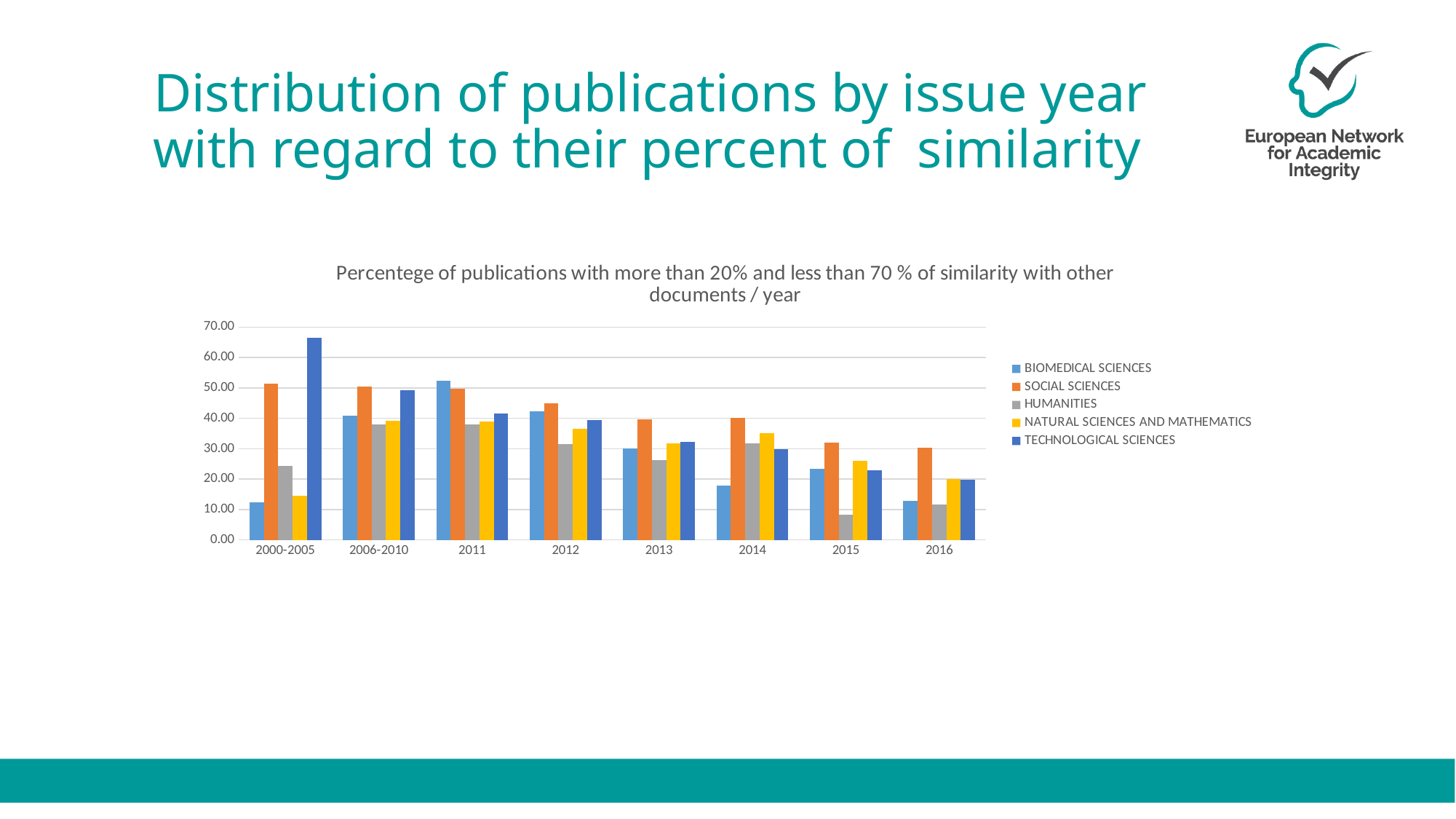
Do the SOCIAL SCIENCES values rise or fall from 2011 to 2016? fall Is the value for TECHNOLOGICAL SCIENCES in 2000-2005 greater or less than 60.00? greater Which series has the tallest bar in the 2000-2005 group? TECHNOLOGICAL SCIENCES Which series has the lowest bar in the 2015 group? HUMANITIES What kind of chart is shown on the slide? bar chart Is the value for HUMANITIES in 2015 greater or less than 10.00? less In 2014, which is larger: SOCIAL SCIENCES or BIOMEDICAL SCIENCES? SOCIAL SCIENCES How many series does the legend list? 5 Is the value for HUMANITIES in 2000-2005 greater or less than 20.00? greater In 2011, which is larger: BIOMEDICAL SCIENCES or TECHNOLOGICAL SCIENCES? BIOMEDICAL SCIENCES How many year categories are shown on the x axis? 8 What colour represents SOCIAL SCIENCES in the legend? orange